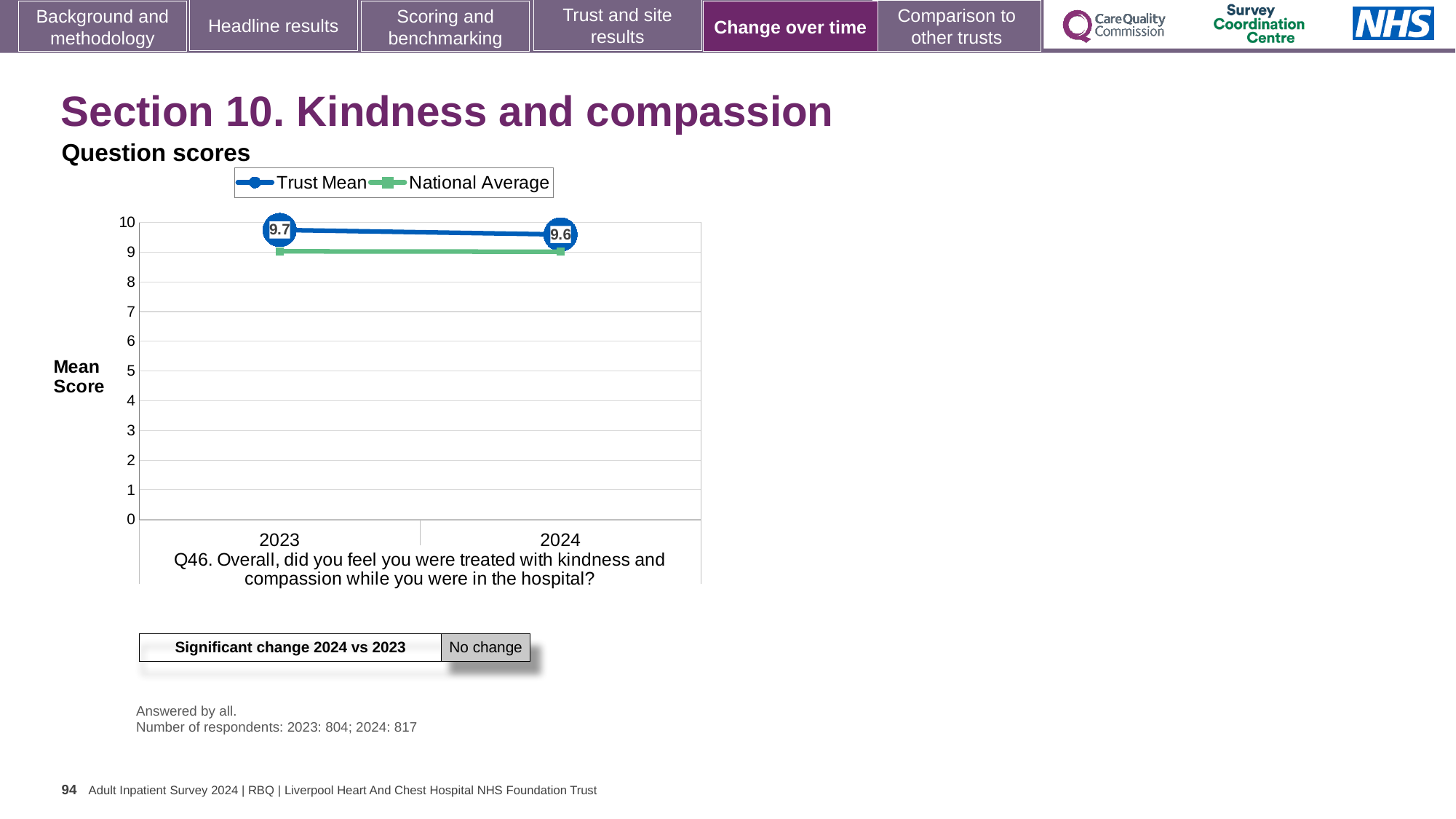
Is the National Average value for 2023 greater or less than 10? less Does the Trust Mean rise or fall from 2023 to 2024? Fall In 2023, which series has the higher value, Trust Mean or National Average? Trust Mean How many series does the chart legend list? 2 What is the Trust Mean score for 2023? 9.7 Is the National Average value for 2024 greater or less than 8? greater How many years are plotted on the x axis of the chart? 2 What is the label of the y axis of the chart? Mean Score What kind of chart is shown on the slide? Line chart What is the difference between the Trust Mean scores for 2023 and 2024? 0.1 What is the Trust Mean score for 2024? 9.6 Which year has the higher Trust Mean score, 2023 or 2024? 2023